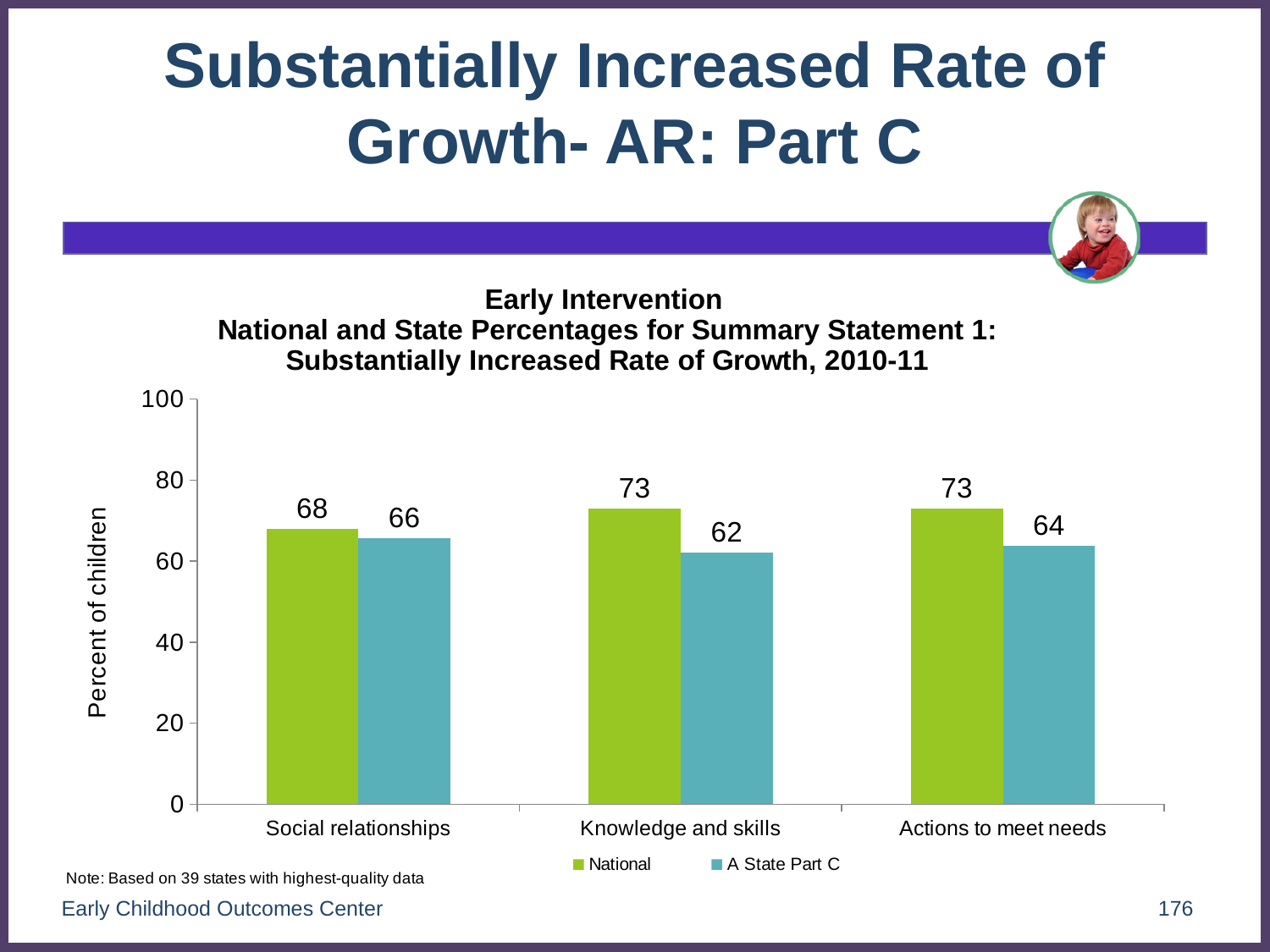
How many categories are shown on the x axis? 3 Which is larger for Actions to meet needs, the National value or the A State Part C value? National Is the A State Part C value for Social relationships greater or less than 60? greater What is the A State Part C value for Actions to meet needs? 64 How many series does the legend list? 2 What is the difference between the National and A State Part C values for Knowledge and skills? 11 Which category has the lowest A State Part C value? Knowledge and skills What kind of chart is shown on the slide? Bar chart Which category has the lowest National value? Social relationships What is the difference between the National and A State Part C values for Social relationships? 2 What is the National value for Social relationships? 68 What is the A State Part C value for Knowledge and skills? 62